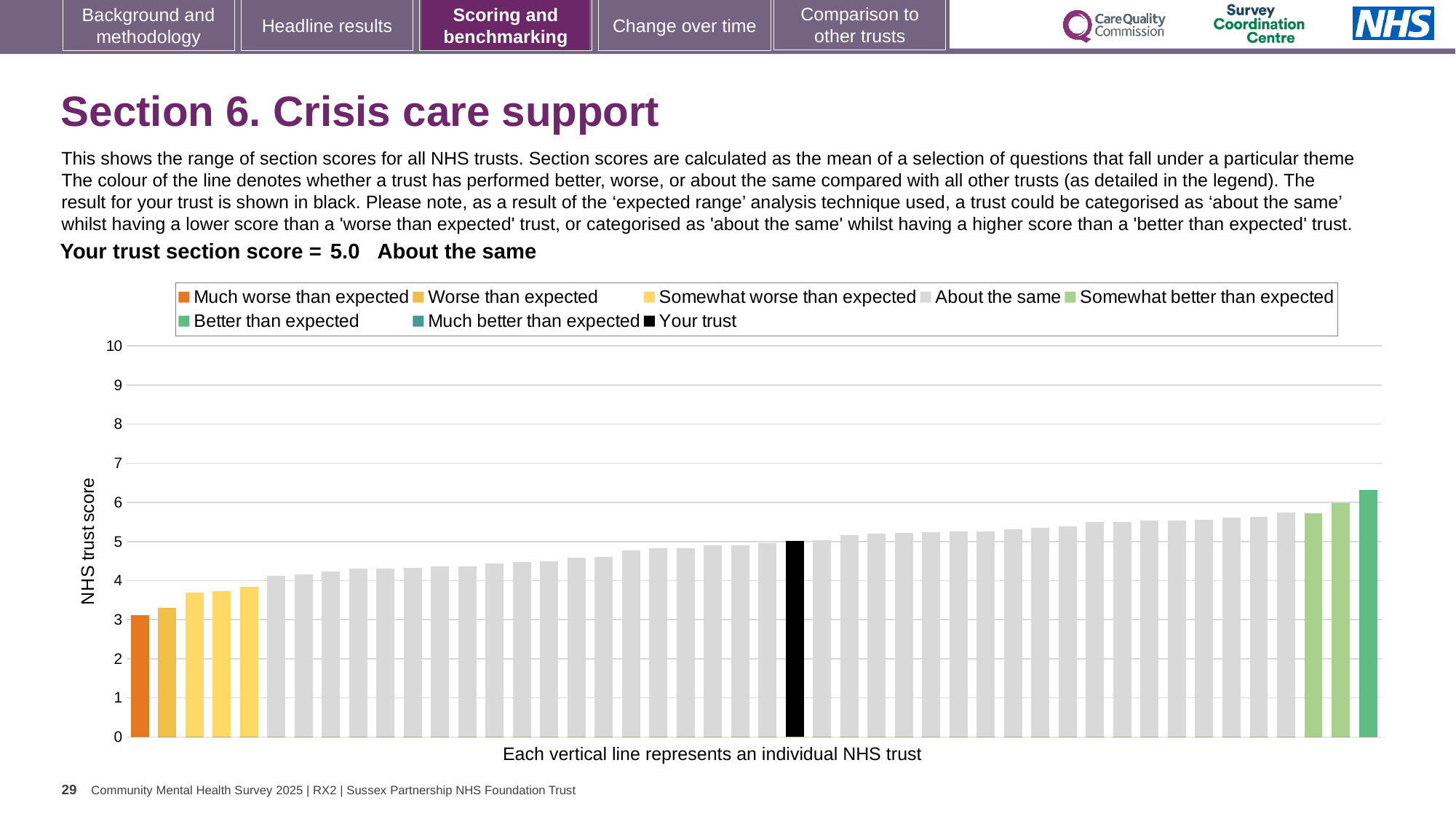
What is the label on the y axis of the chart? NHS trust score How many bars are coloured as 'Somewhat better than expected'? 2 Is the value of the highest bar greater or less than 6? greater Which legend category does the highest bar belong to? Better than expected What kind of chart is shown on the slide? bar chart What is the section score for your trust shown on the slide? 5.0 Is the value of the highest bar greater or less than 7? less How many entries does the chart legend list? 8 How many bars are coloured as 'Much worse than expected'? 1 Do the bar values rise or fall from left to right along the x axis? rise Is the value of the lowest bar greater or less than 4? less Which category is your trust's section score placed in? About the same